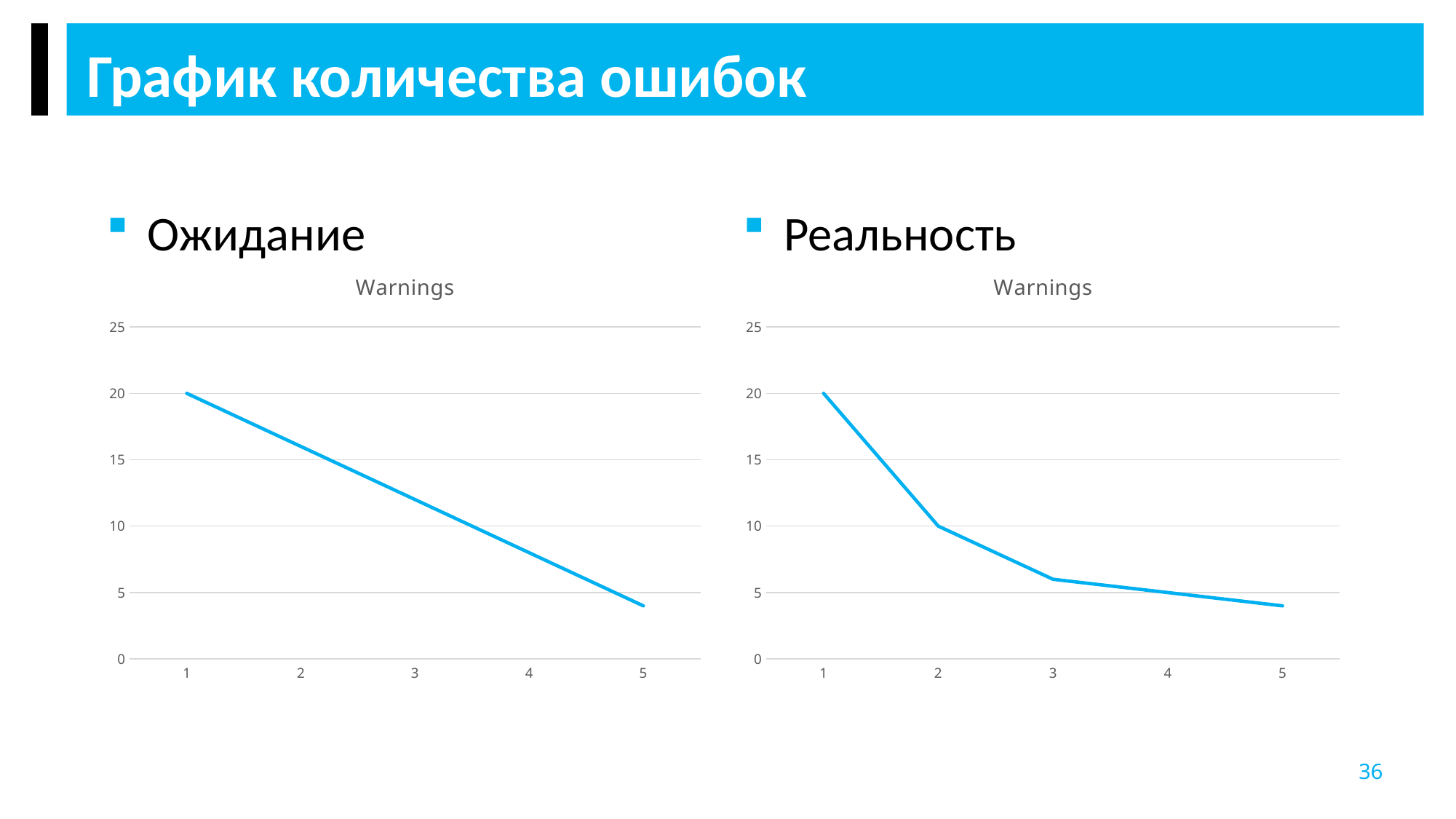
In the left chart (under "Ожидание"), is the value at x = 5 greater or less than 5? less What kind of chart is the left chart (under "Ожидание")? line chart How many data points are plotted in the right chart (under "Реальность")? 5 In the right chart (under "Реальность"), what is the difference between the values at x = 1 and x = 2? 10 In the left chart (under "Ожидание"), is the value at x = 3 greater or less than 10? greater In the right chart (under "Реальность"), what is the value at x = 1? 20 In the left chart (under "Ожидание"), do the values rise or fall along the x axis? fall What is the title of the right chart (under "Реальность")? Warnings In the left chart (under "Ожидание"), what is the value at x = 1? 20 In the right chart (under "Реальность"), what is the value at x = 2? 10 In the right chart (under "Реальность"), is the value at x = 3 greater or less than 5? greater In the left chart (under "Ожидание"), at which x value is the plotted value highest? 1